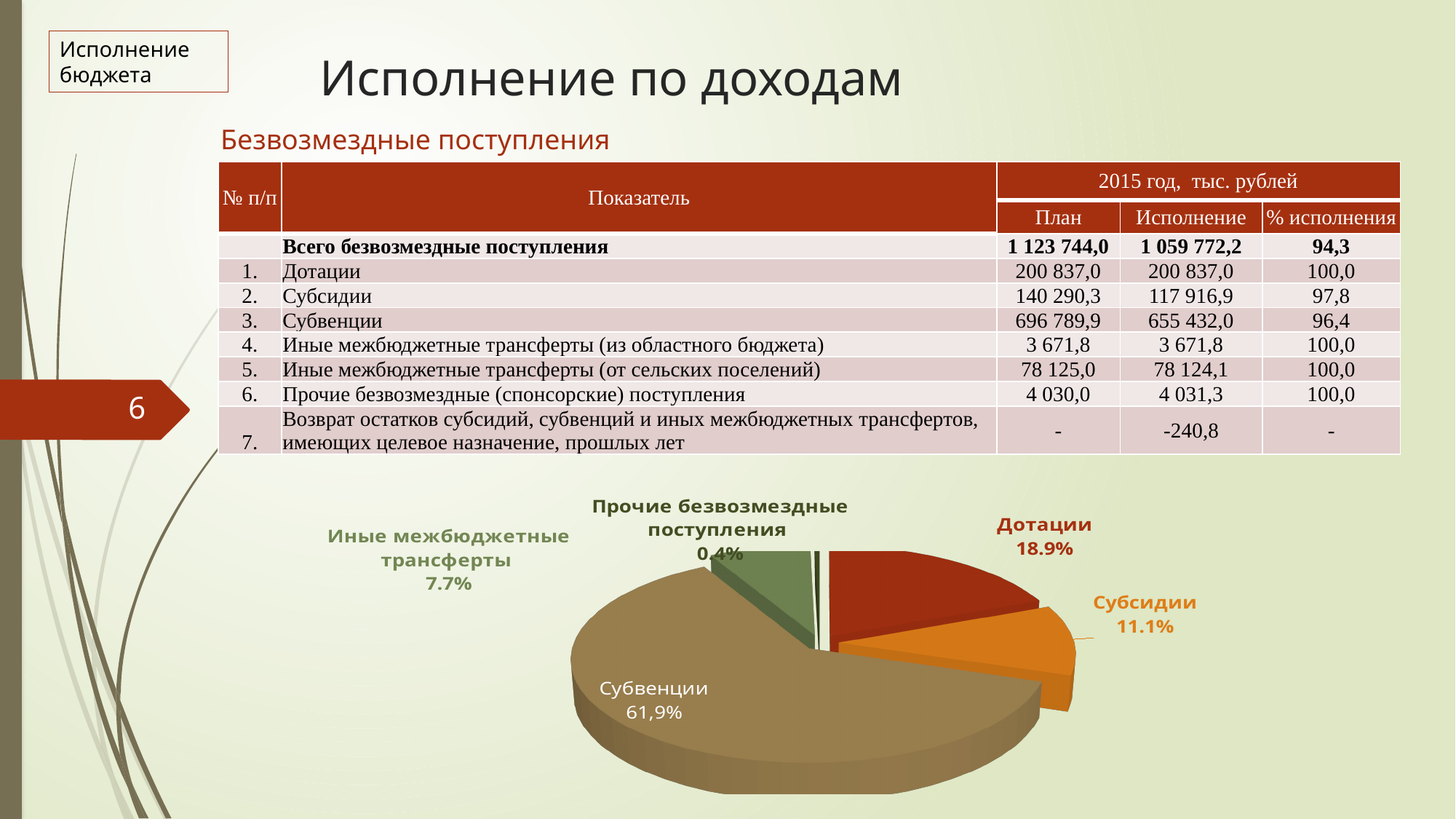
What colour is the Субвенции slice in the pie chart? brown In the pie chart, what share is shown for Прочие безвозмездные поступления? 0.4% In the pie chart, which is larger: Дотации or Субсидии? Дотации In the pie chart, what share is shown for Иные межбюджетные трансферты? 7.7% In the pie chart, what share is shown for Дотации? 18.9% In the pie chart, what is the difference in percentage points between Субсидии and Иные межбюджетные трансферты? 3.4 Which slice of the pie chart is the largest? Субвенции In the pie chart, what is the difference in percentage points between Дотации and Субсидии? 7.8 Which labelled slice of the pie chart is the smallest? Прочие безвозмездные поступления What type of chart is shown at the bottom of the slide? pie chart